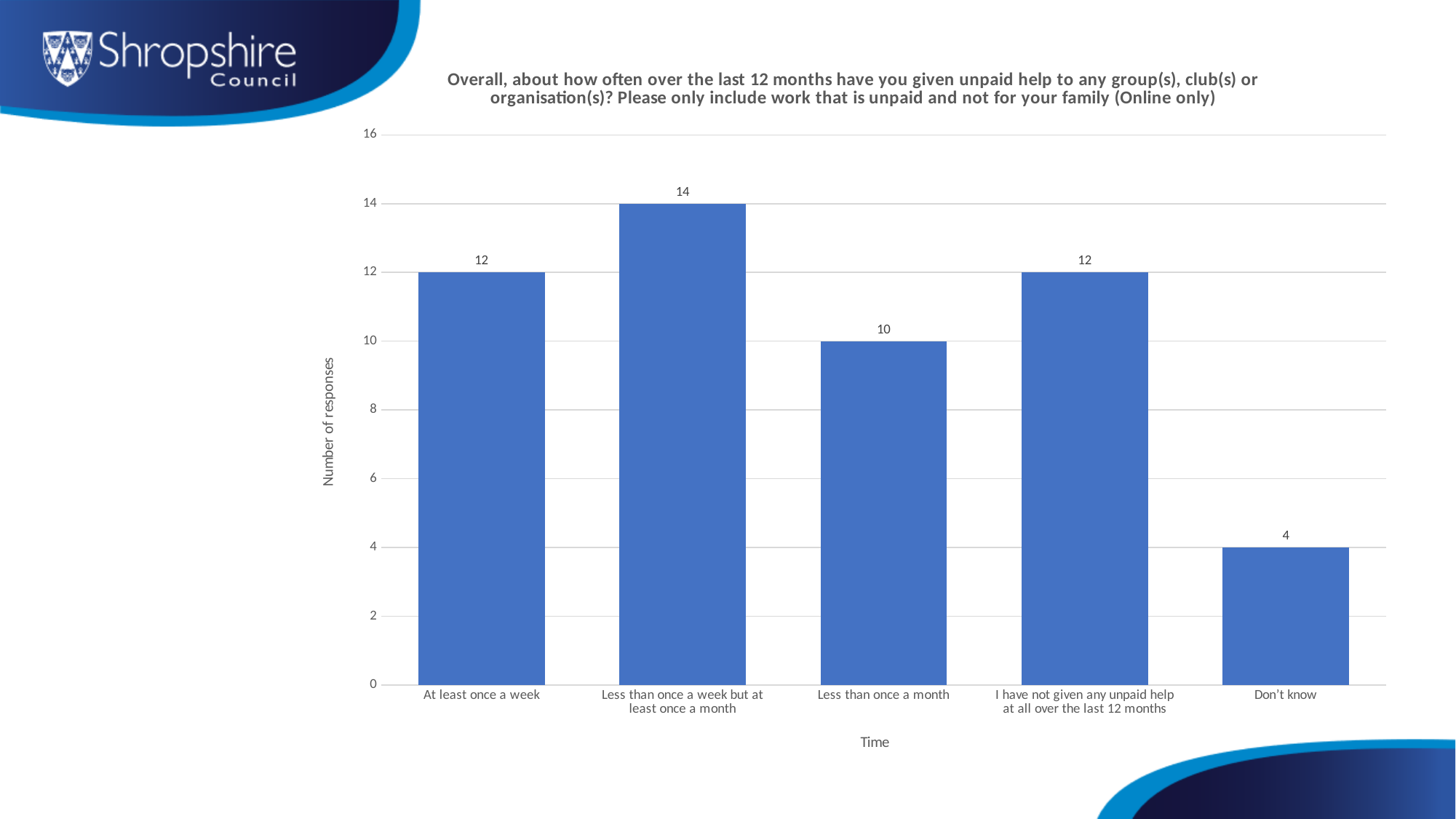
Which has more responses: 'Less than once a month' or 'I have not given any unpaid help at all over the last 12 months'? I have not given any unpaid help at all over the last 12 months What is the number of responses for 'Less than once a month'? 10 What is the number of responses for 'Less than once a week but at least once a month'? 14 How many responses are shown for 'Don't know'? 4 What kind of chart is shown on the slide? Bar chart Which category has the lowest number of responses? Don't know How many categories are shown on the x axis? 5 What is the label of the y axis? Number of responses What is the label of the x axis? Time How many responses are shown for 'At least once a week'? 12 What is the difference in responses between 'Less than once a week but at least once a month' and 'Don't know'? 10 Which category has the highest number of responses? Less than once a week but at least once a month